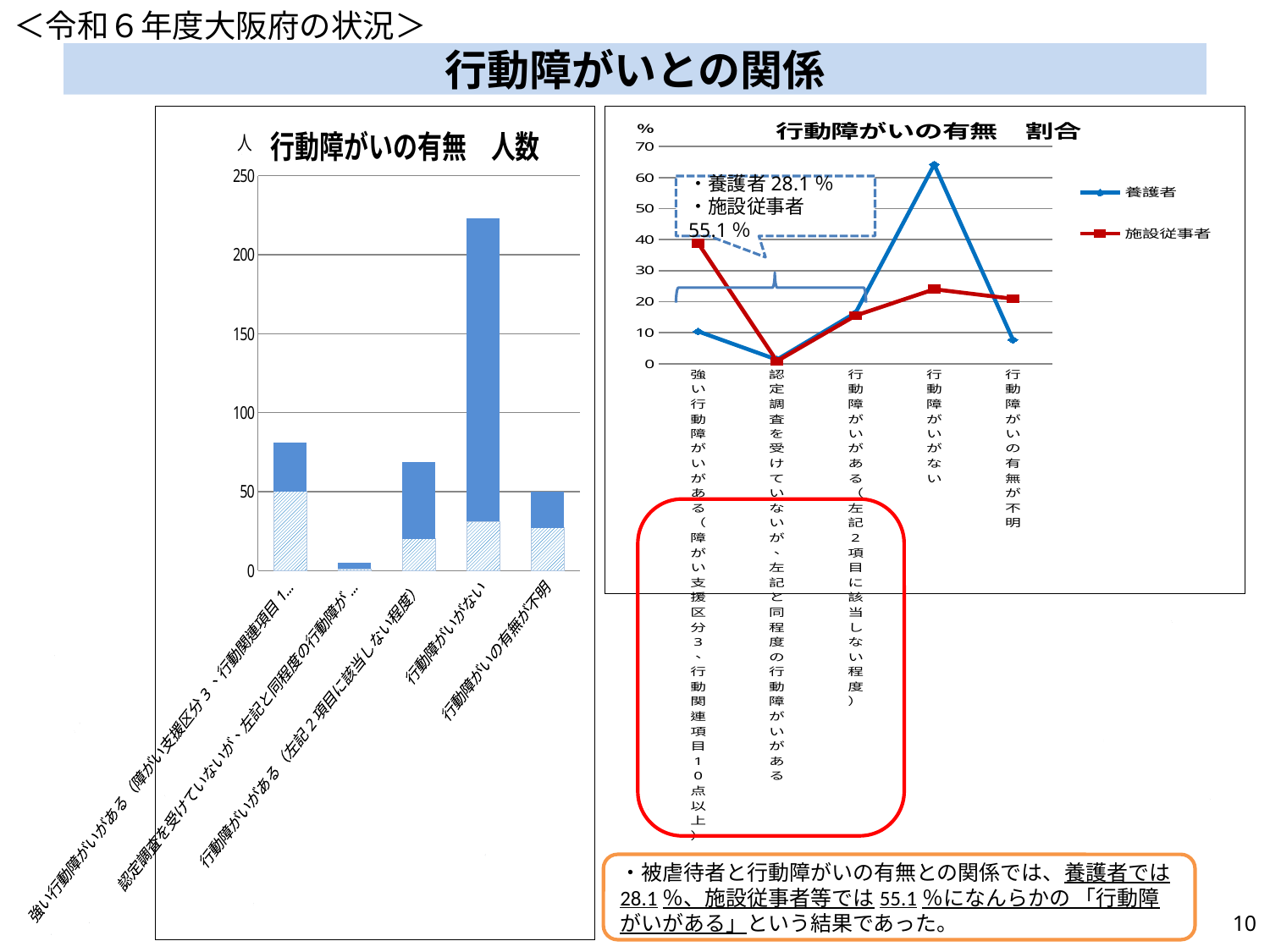
How many series does the legend of the right chart (行動障がいの有無 割合) list? 2 What kind of chart is the left chart titled 行動障がいの有無 人数? bar chart In the right chart (行動障がいの有無 割合), at which category does the 養護者 line reach its highest value? 行動障がいがない What kind of chart is the right chart titled 行動障がいの有無 割合? line chart How many categories are shown on the x axis of the left chart (行動障がいの有無 人数)? 5 In the left chart (行動障がいの有無 人数), which category has the tallest bar? 行動障がいがない What are the two legend entries in the right chart (行動障がいの有無 割合)? 養護者, 施設従事者 In the left chart (行動障がいの有無 人数), is the total bar for 行動障がいがない greater or less than 200? greater In the right chart (行動障がいの有無 割合), which series has the larger value for 強い行動障がいがある, 養護者 or 施設従事者? 施設従事者 In the left chart (行動障がいの有無 人数), which category has the shortest bar? 認定調査を受けていないが、左記と同程度の行動障が… In the right chart (行動障がいの有無 割合), is the 養護者 value for 行動障がいがない greater or less than 60? greater In the left chart (行動障がいの有無 人数), is the total bar for 行動障がいの有無が不明 greater or less than 100? less